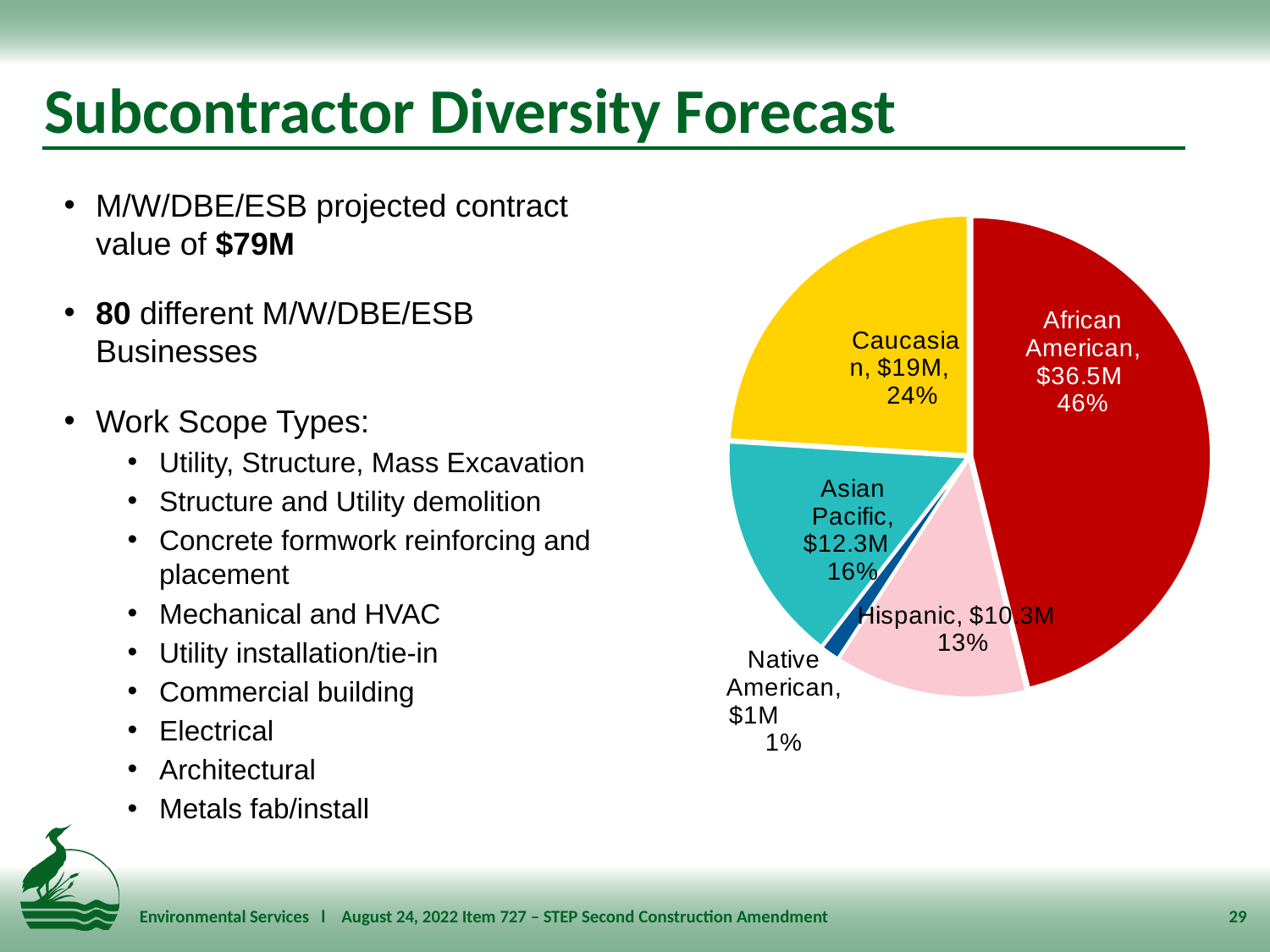
Which category has the largest slice of the pie chart? African American Which is larger, the Asian Pacific value or the Hispanic value? Asian Pacific What kind of chart is shown on the slide? pie chart What is the value for Caucasian in the pie chart? $19M What is the value for Hispanic in the pie chart? $10.3M Which category has the smallest slice of the pie chart? Native American What is the value for African American in the pie chart? $36.5M What is the value for Asian Pacific in the pie chart? $12.3M How many slices does the pie chart have? 5 What share of the pie does African American represent? 46% What share of the pie does Native American represent? 1% What is the difference between the African American and Caucasian values? $17.5M